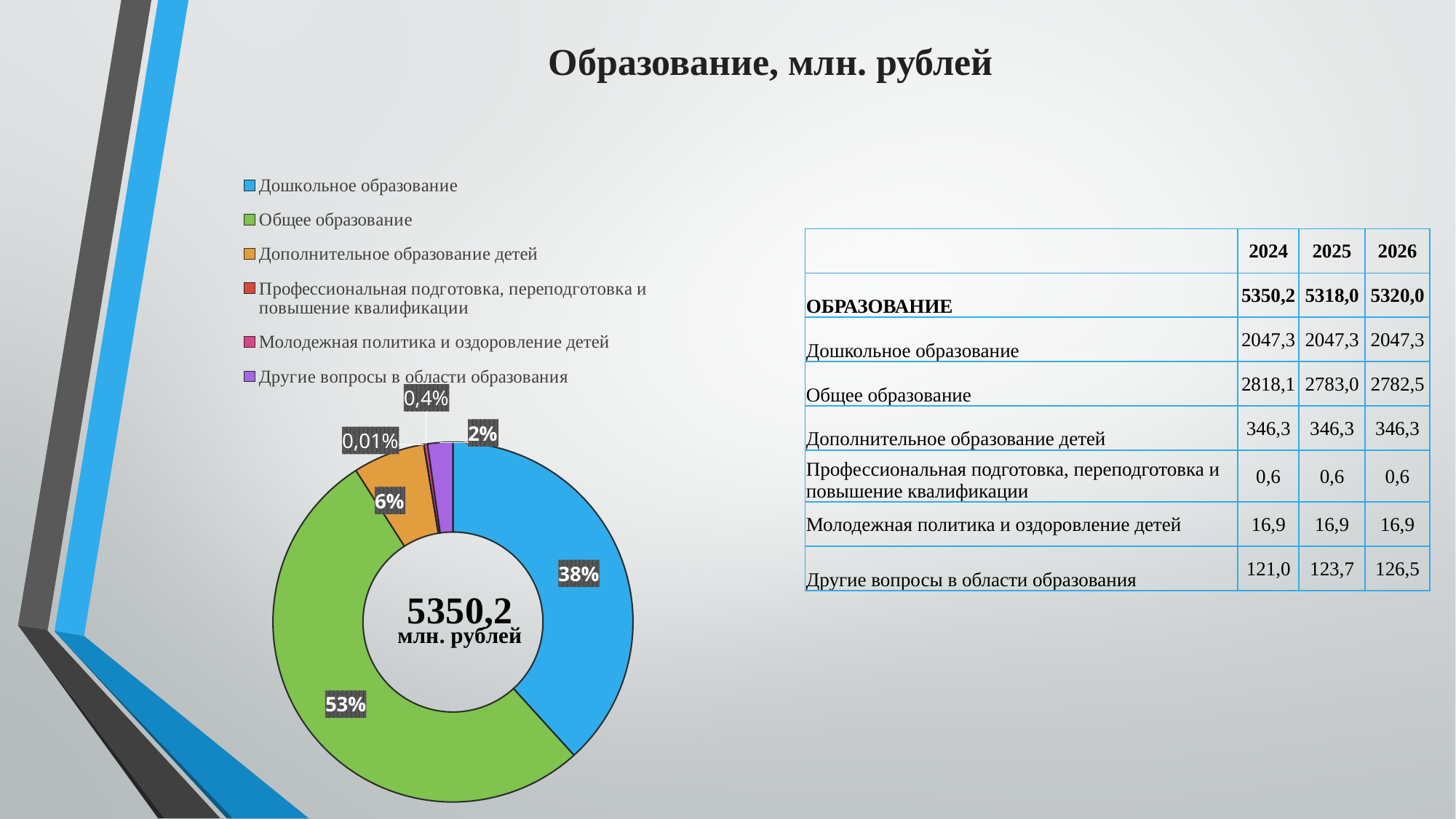
What kind of chart is shown on the slide? Doughnut (pie) chart Which category has the largest slice in the doughnut chart? Общее образование What is the difference in percentage points between the "Общее образование" and "Дошкольное образование" slices? 15 How many categories does the legend of the doughnut chart list? 6 Which slice is larger: "Дополнительное образование детей" or "Другие вопросы в области образования"? Дополнительное образование детей What share of the doughnut chart does "Общее образование" have? 53% What total value is printed in the centre of the doughnut chart? 5350,2 млн. рублей What share of the doughnut chart does "Дошкольное образование" have? 38% What share of the doughnut chart does "Дополнительное образование детей" have? 6% Which category has the smallest slice in the doughnut chart? Профессиональная подготовка, переподготовка и повышение квалификации